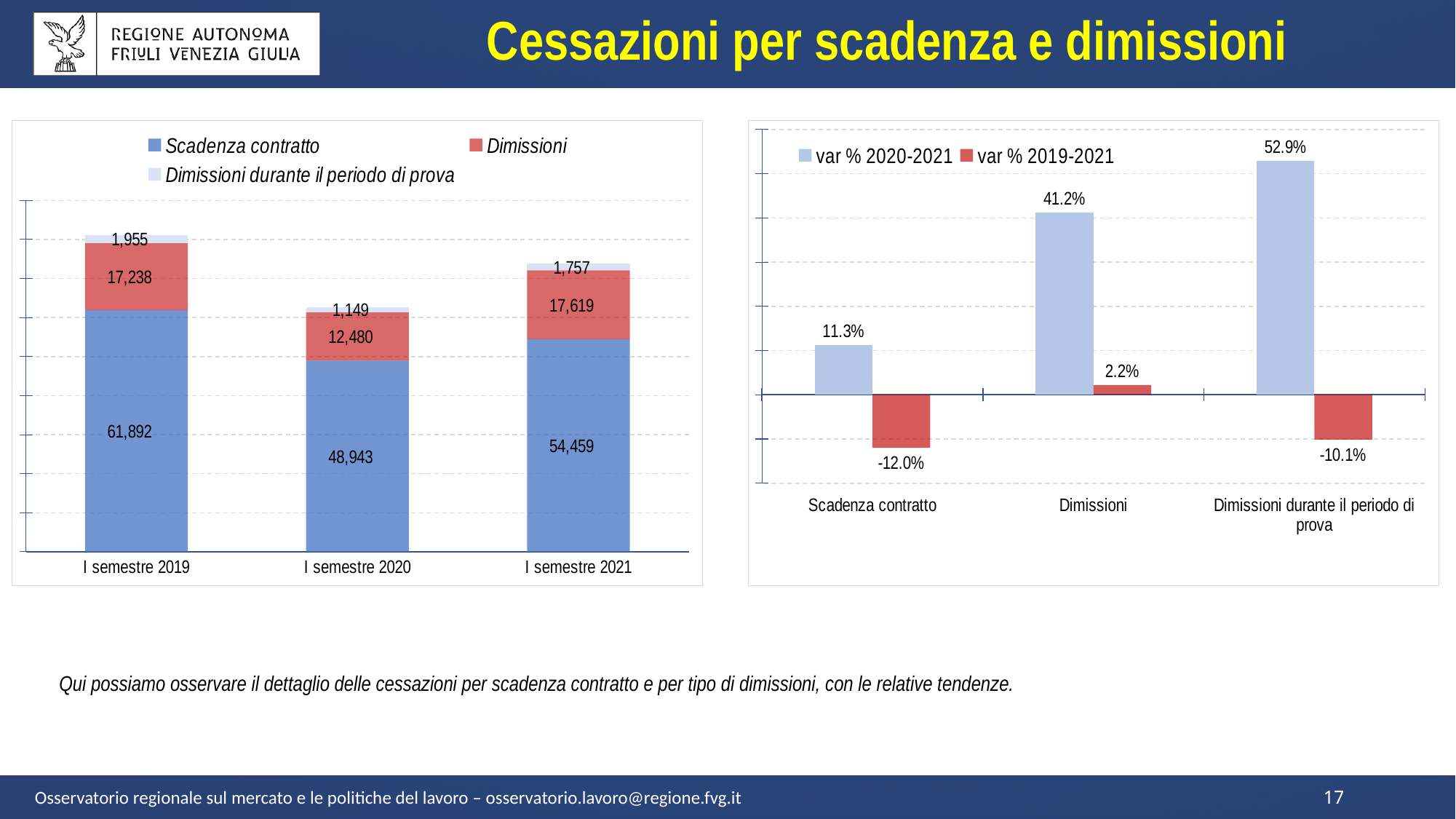
What kind of chart is the left chart? Stacked bar chart In the right chart, which is larger: the var % 2019-2021 for Dimissioni or for Dimissioni durante il periodo di prova? Dimissioni In the right chart, what is the var % 2020-2021 for Dimissioni? 41.2% In the left chart, what is the total of the stacked bar for I semestre 2020? 62,572 In the left chart, what is the difference between Scadenza contratto in I semestre 2019 and I semestre 2021? 7,433 In the right chart, which category has the highest var % 2020-2021? Dimissioni durante il periodo di prova In the right chart, what is the var % 2019-2021 for Scadenza contratto? -12.0% In the left chart, which semester has the lowest value for Scadenza contratto? I semestre 2020 In the left chart, what is the value of Dimissioni for I semestre 2020? 12,480 How many series does the legend of the left chart list? 3 In the left chart, what is the value of Dimissioni durante il periodo di prova for I semestre 2021? 1,757 In the left chart, what is the value of Scadenza contratto for I semestre 2019? 61,892